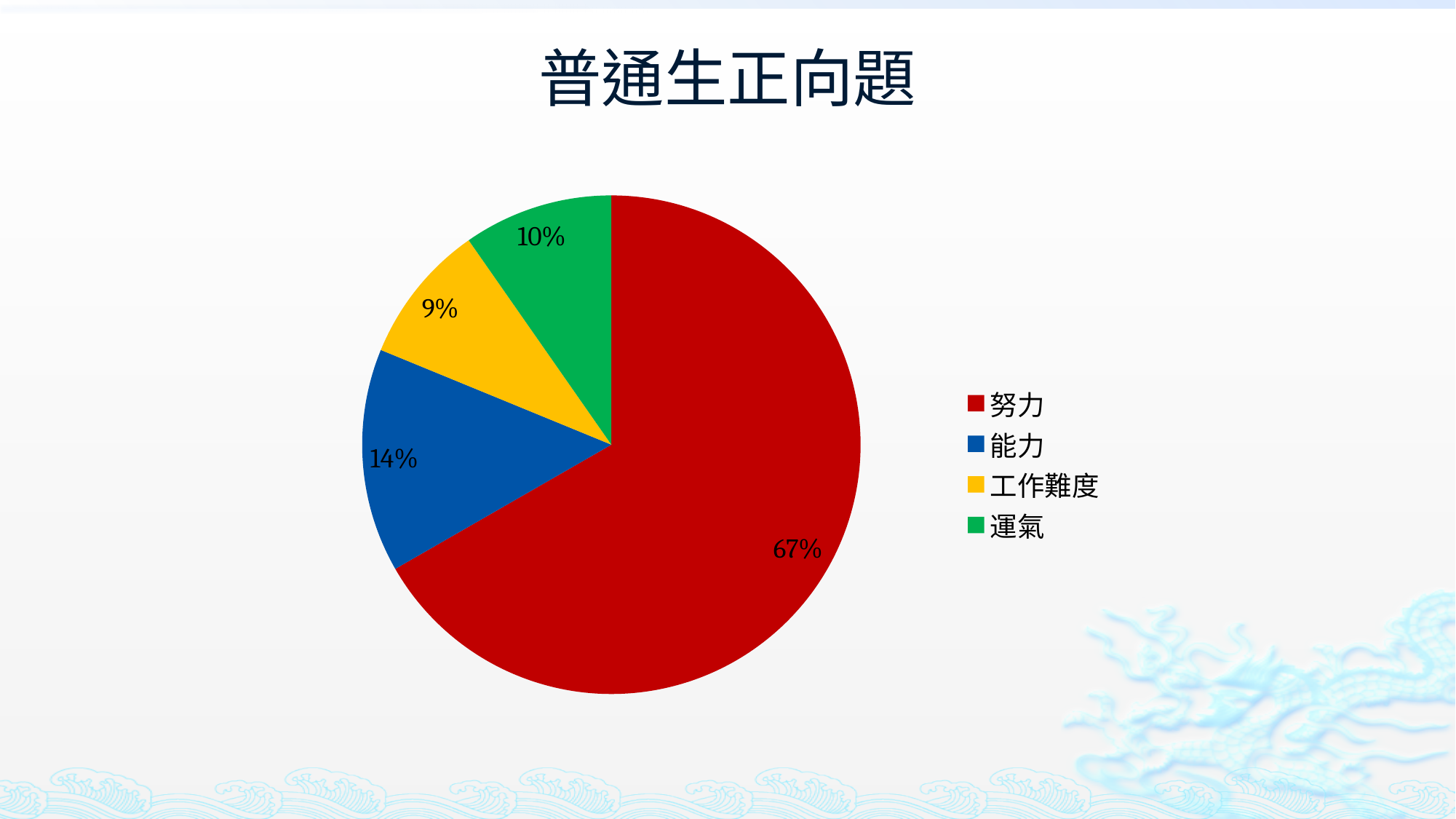
What kind of chart is shown on the slide? pie chart Which category has the smallest slice? 工作難度 What colour is the slice for 工作難度? yellow What share of the pie does 努力 take? 67% What share of the pie does 工作難度 take? 9% Which category has the largest slice? 努力 What is the difference in percentage points between 努力 and 能力? 53 What share of the pie does 運氣 take? 10% Which is larger, the slice for 能力 or the slice for 運氣? 能力 What is the title of the chart? 普通生正向題 How many categories does the pie chart have? 4